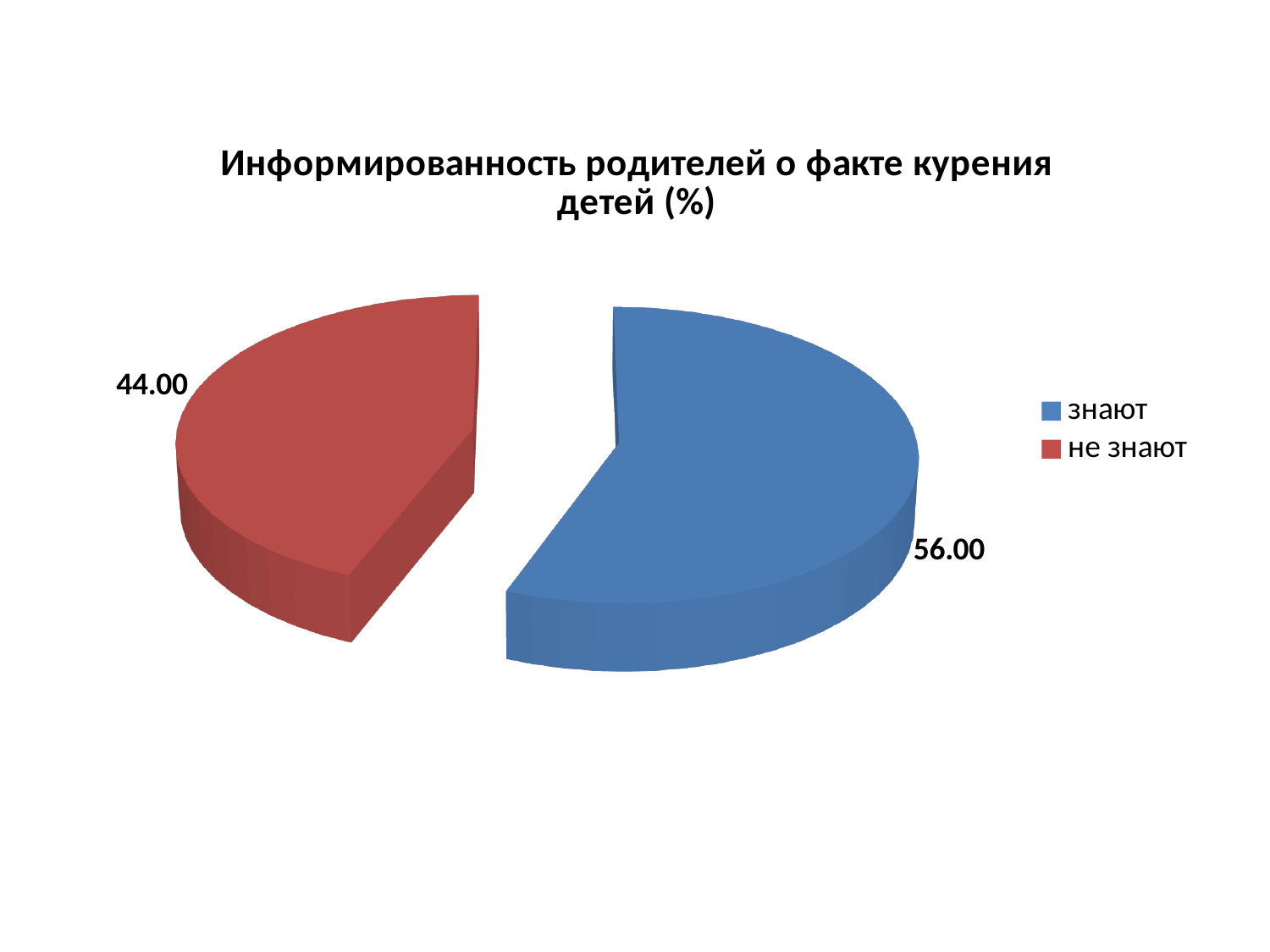
What colour is the slice for "не знают"? red What type of chart is shown on the slide? pie chart What is the title of the chart? Информированность родителей о факте курения детей (%) What share of the pie does the "знают" slice represent? 56.00% How many slices does the pie chart have? 2 What is the value for "знают"? 56.00 What is the difference between the values for "знают" and "не знают"? 12.00 What is the value for "не знают"? 44.00 Which category has the smallest slice? не знают Which is larger, the value for "знают" or the value for "не знают"? знают Which category has the largest slice? знают How many entries does the legend list? 2